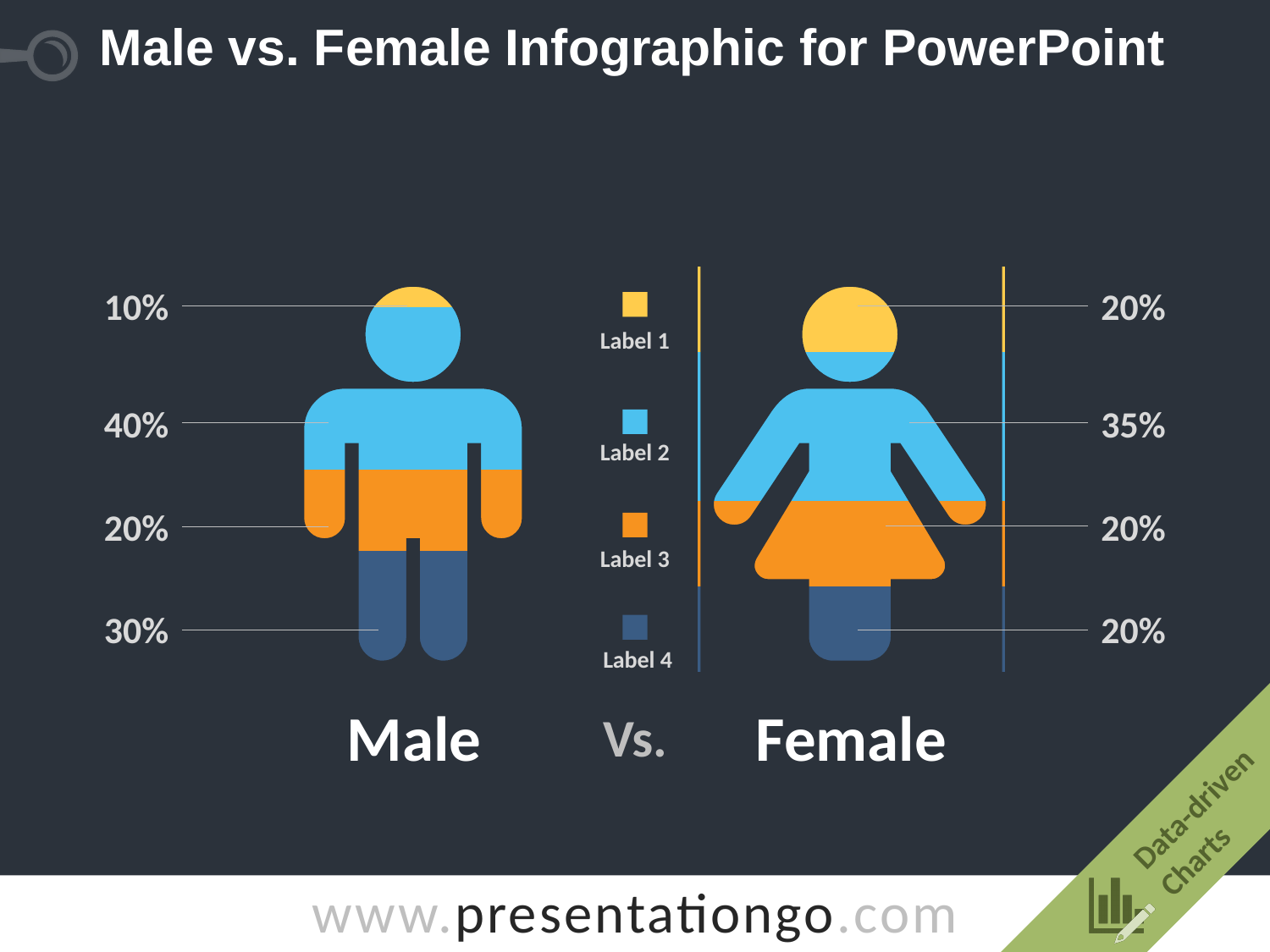
What colour represents Label 3 in the legend? Orange Which label has the highest value for Female? Label 2 Which label has the lowest value for Male? Label 1 What is the value for Label 4 in the Male figure? 30% What is the value for Label 3 in the Female figure? 20% How many labels does the legend list? 4 What is the difference between the Male values for Label 2 and Label 1? 30% What is the value for Label 1 in the Male figure? 10% Which label has the highest value for Male? Label 2 Which is larger, the Male value for Label 4 or the Female value for Label 4? Male What is the difference between the Male and Female values for Label 2? 5% What is the value for Label 2 in the Female figure? 35%